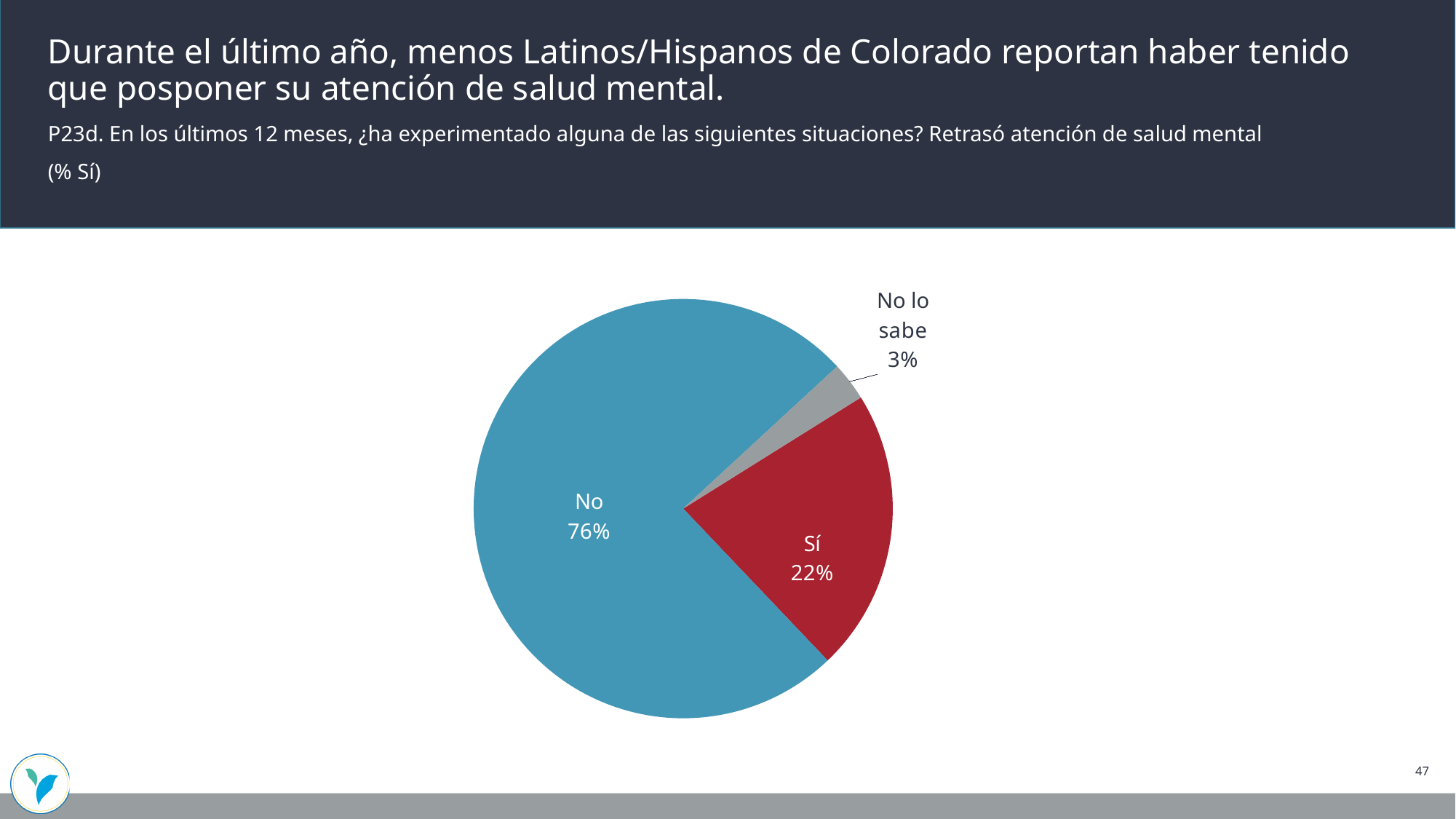
What share of the pie does the "Sí" slice represent? 22% How many slices does the pie chart have? 3 What percentage of respondents answered "No lo sabe"? 3% What kind of chart is shown on the slide? pie chart Which response has the largest share of the pie? No What colour is the "No" slice? blue Which response has the smallest share of the pie? No lo sabe What is the difference in percentage points between the "No" and "Sí" slices? 54 What colour is the "Sí" slice? red What percentage of respondents answered "No"? 76% What percentage of respondents answered "Sí"? 22% Which slice is larger, "Sí" or "No lo sabe"? Sí